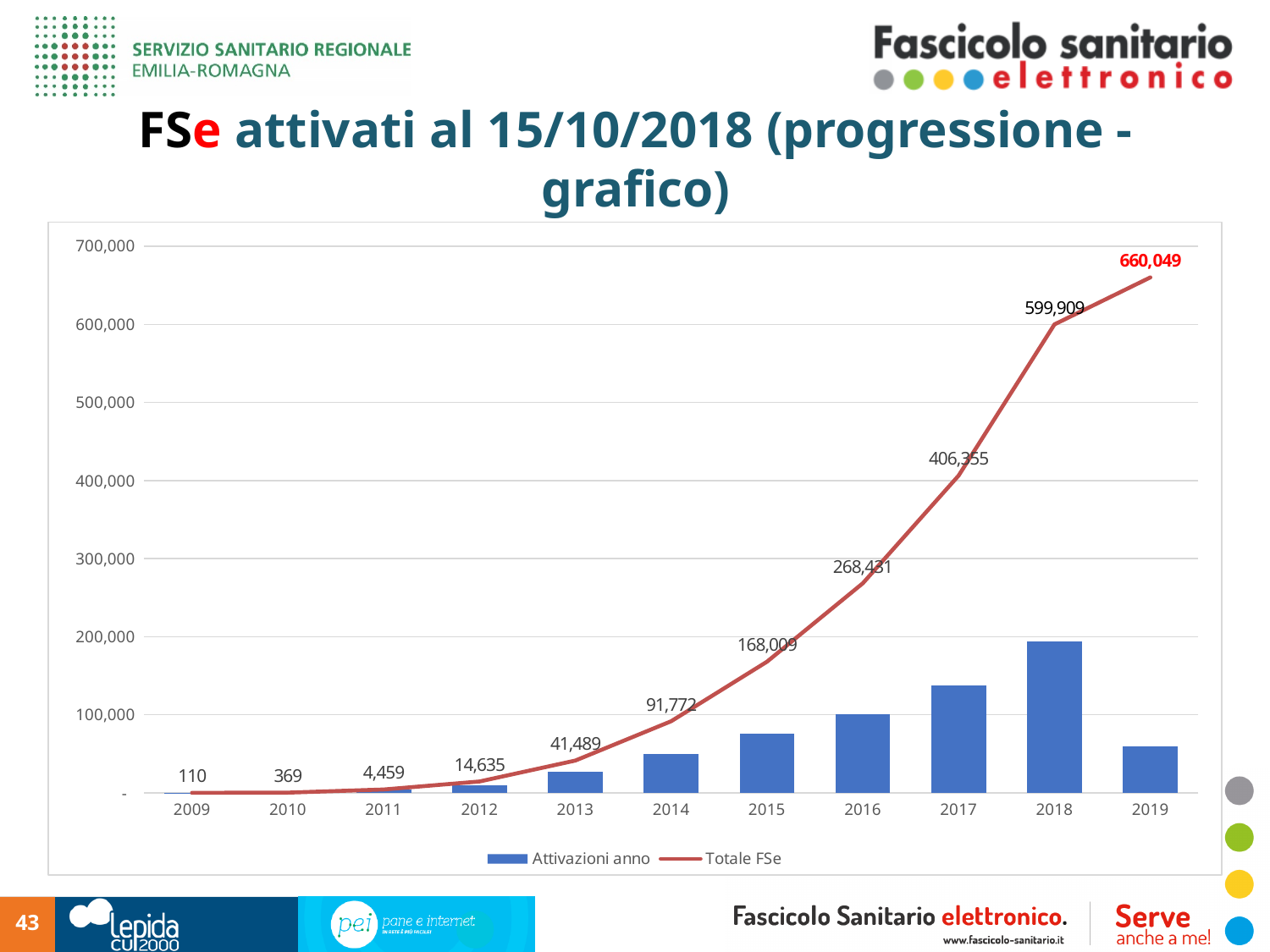
Which year has the highest Totale FSe value? 2019 Is the Attivazioni anno bar for 2018 greater or less than 100,000? greater Which year has the tallest Attivazioni anno bar? 2018 What is the Totale FSe value for 2019? 660,049 What is the difference between the Totale FSe values for 2019 and 2018? 60,140 What is the Totale FSe value for 2012? 14,635 Which year has the lowest Totale FSe value? 2009 How many years are shown on the x axis? 11 Does the Totale FSe line rise or fall from 2009 to 2019? rise What is the Totale FSe value for 2018? 599,909 How many series does the legend list? 2 What is the Totale FSe value for 2013? 41,489